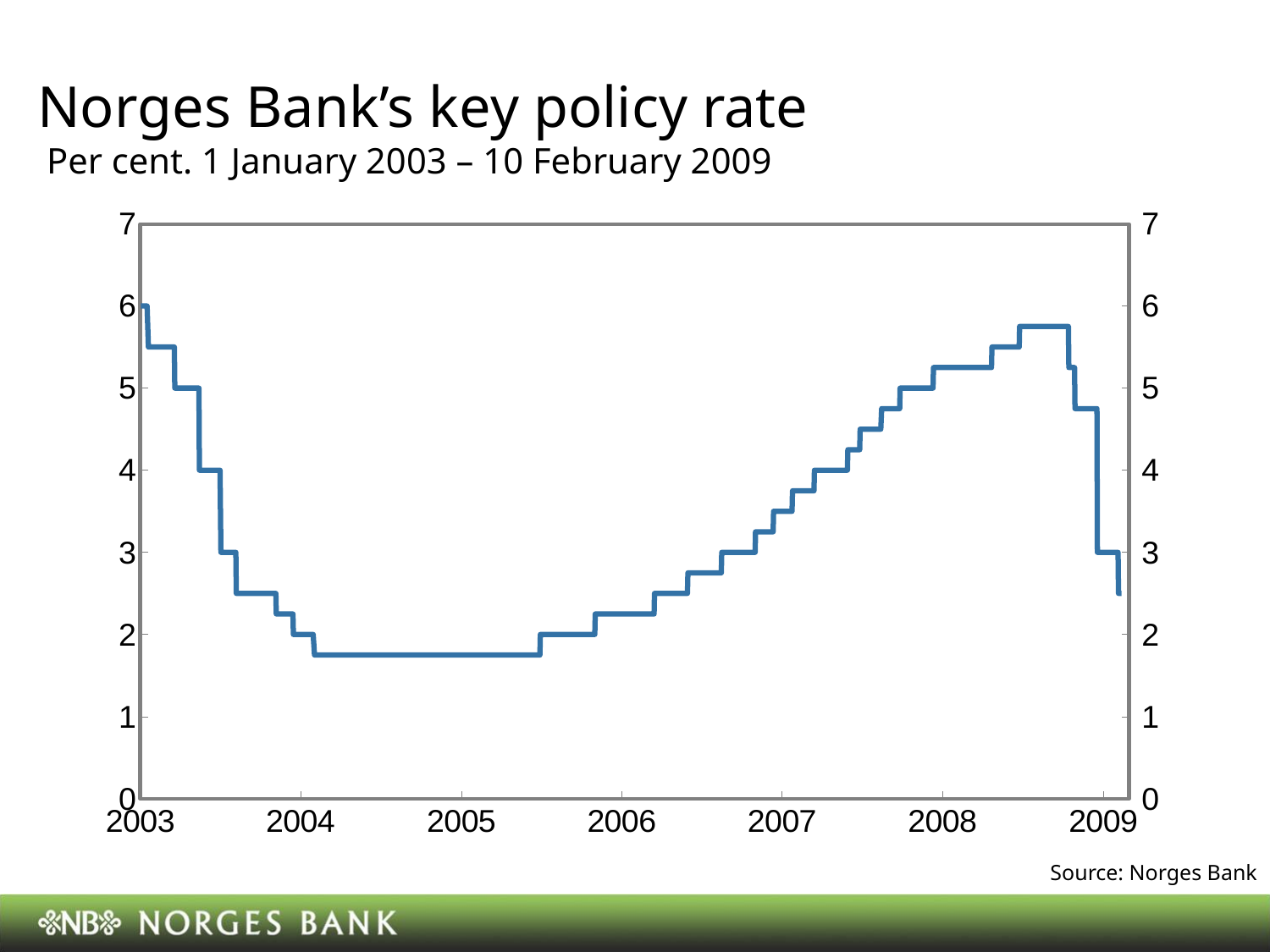
What is the title of the chart? Norges Bank's key policy rate Is the key policy rate at the start of 2005 greater or less than 2? less What is the key policy rate at the start of 2009? 3 Which is higher, the key policy rate at the start of 2008 or at the start of 2005? Start of 2008 Does the key policy rate rise or fall between the start of 2003 and the start of 2004? fall Does the key policy rate rise or fall between the start of 2006 and the start of 2008? rise Is the highest key policy rate reached in 2008 greater or less than 6? less Is the key policy rate at the start of 2008 greater or less than 5? greater What kind of chart is shown on the slide? Line chart What is the key policy rate at the start of 2003? 6 What period does the chart cover, according to the subtitle? 1 January 2003 – 10 February 2009